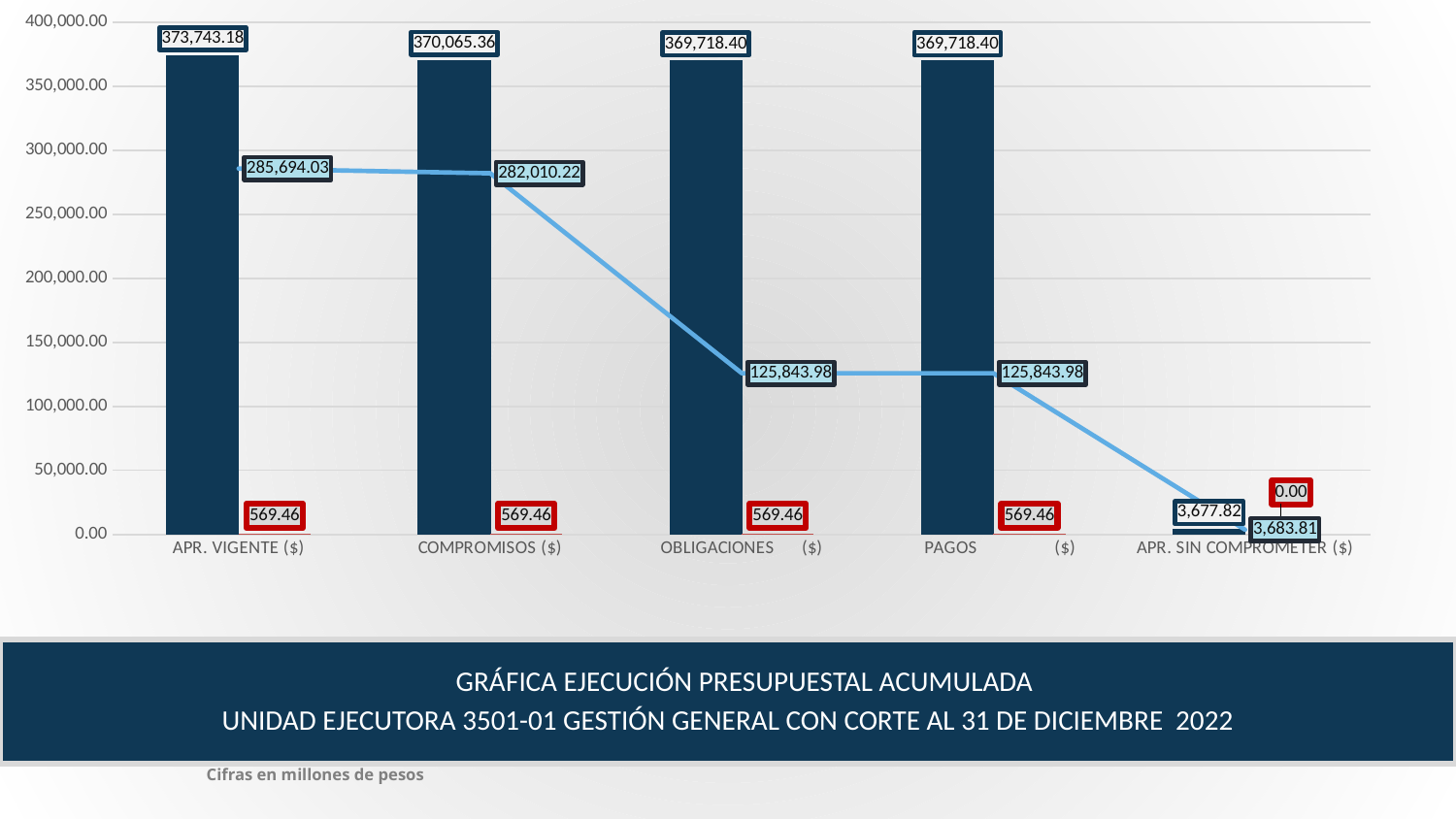
What kind of chart is shown on the slide? A bar chart combined with a line Which category has the highest dark blue bar? APR. VIGENTE ($) What value does the light blue line show at OBLIGACIONES ($)? 125,843.98 Which category has the lowest dark blue bar? APR. SIN COMPROMETER ($) What is the value of the red bar for PAGOS ($)? 569.46 What is the value of the dark blue bar for APR. VIGENTE ($)? 373,743.18 What is the value of the dark blue bar for APR. SIN COMPROMETER ($)? 3,677.82 How many categories are shown on the x axis? 5 Is the light blue line value higher at COMPROMISOS ($) or at OBLIGACIONES ($)? COMPROMISOS ($) What is the value of the red bar for APR. SIN COMPROMETER ($)? 0.00 Does the light blue line rise or fall from left to right across the categories? Falls What is the difference between the dark blue bar values for APR. VIGENTE ($) and COMPROMISOS ($)? 3,677.82